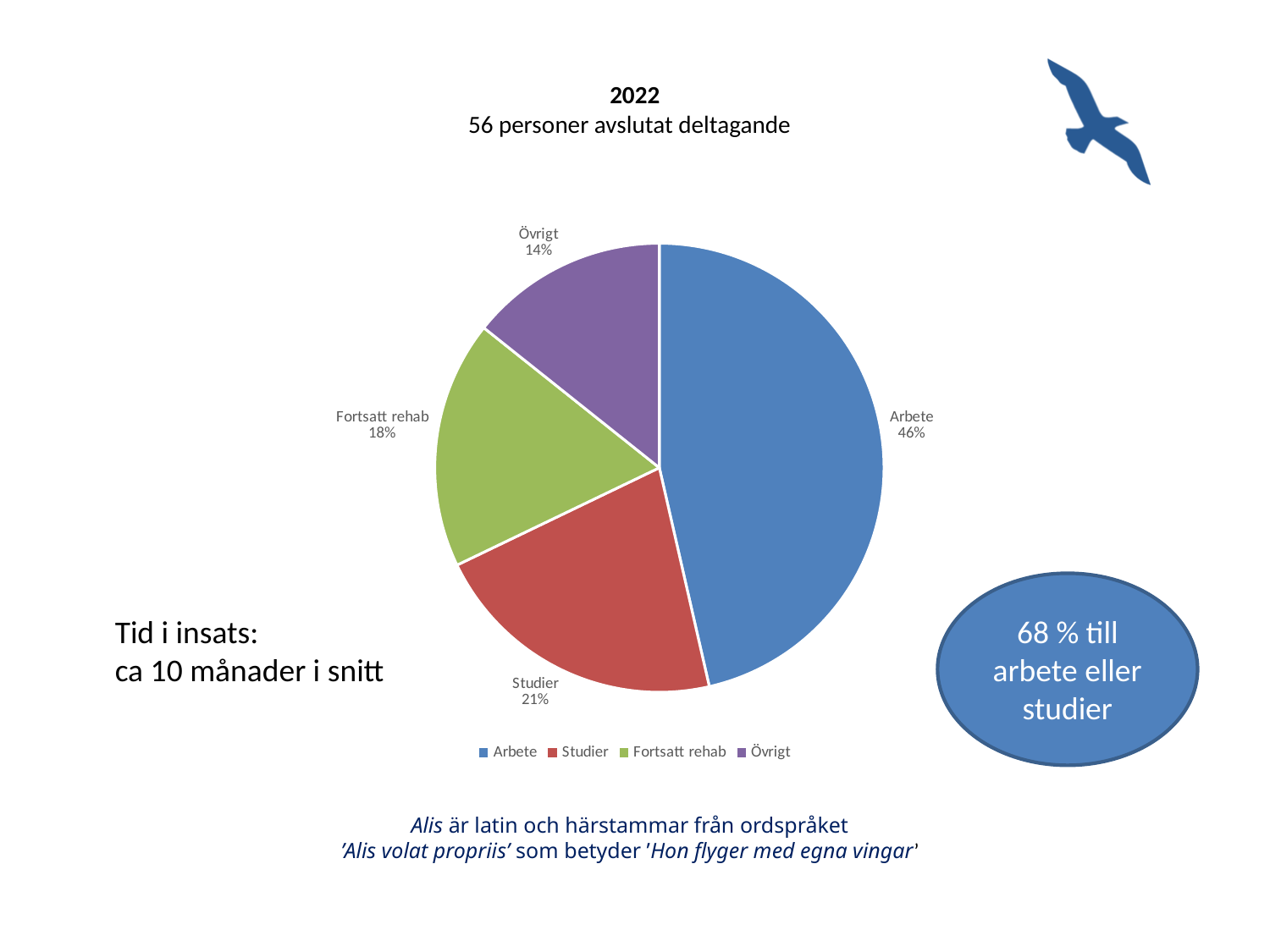
What share of the pie does Arbete represent? 46% What share of the pie does Övrigt represent? 14% What share of the pie does Studier represent? 21% What colour is the Studier slice? Red What is the difference in percentage points between Arbete and Studier? 25 Which category has the smallest slice of the pie? Övrigt What kind of chart is shown on the slide? Pie chart Which category has the largest slice of the pie? Arbete Which is larger, the share for Fortsatt rehab or the share for Övrigt? Fortsatt rehab What is the title of the chart? 2022 56 personer avslutat deltagande How many categories are shown in the pie chart? 4